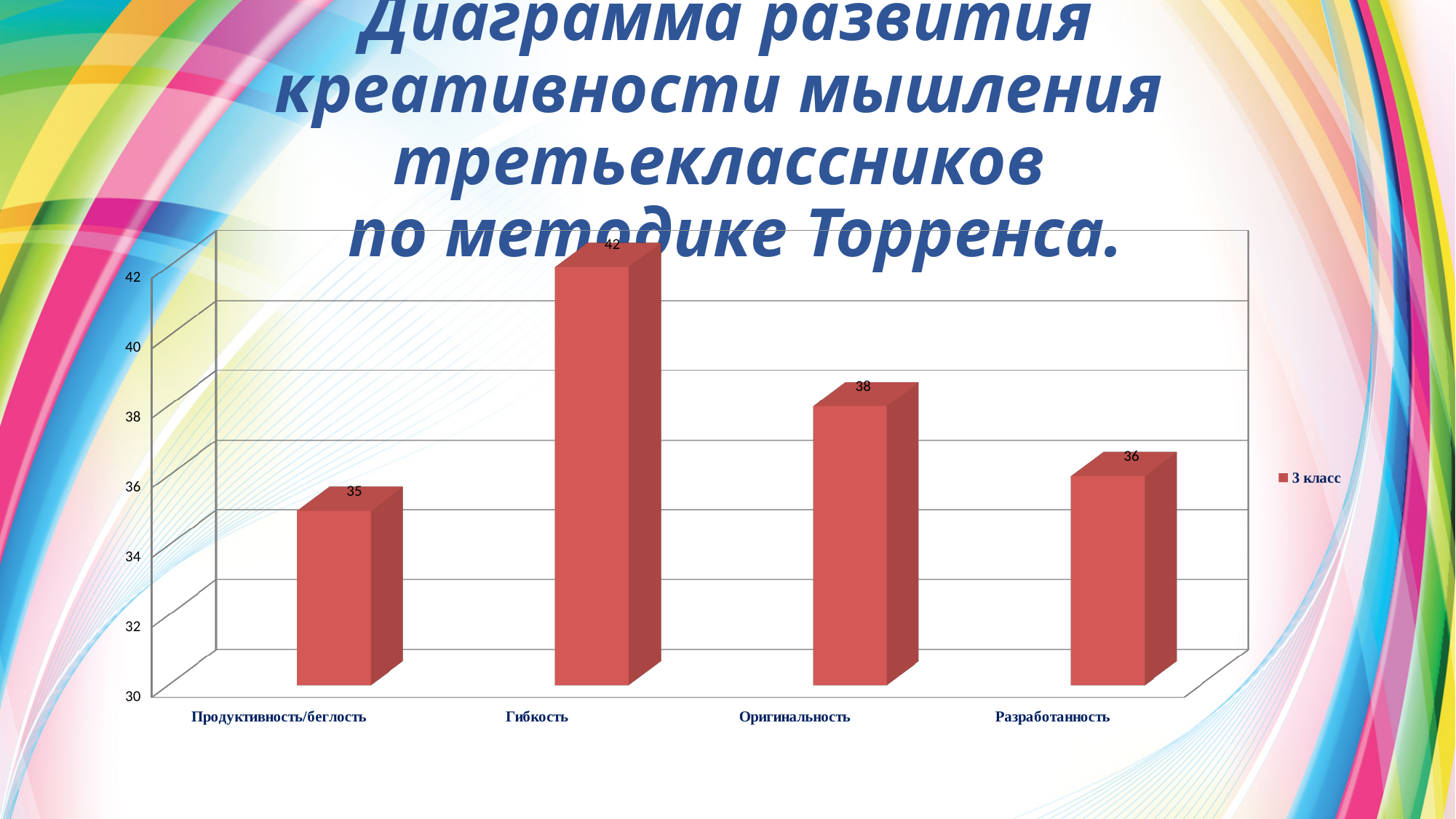
Which category has the highest value? Гибкость What kind of chart is shown on the slide? Bar chart What is the value for Разработанность? 36 What is the difference between the values for Гибкость and Продуктивность/беглость? 7 What is the difference between the values for Оригинальность and Разработанность? 2 How many series does the legend list? 1 What is the value for Оригинальность? 38 Which is larger, the value for Оригинальность or the value for Разработанность? Оригинальность How many categories are shown on the x axis? 4 What is the value for Гибкость? 42 What is the value for Продуктивность/беглость? 35 Which category has the lowest value? Продуктивность/беглость